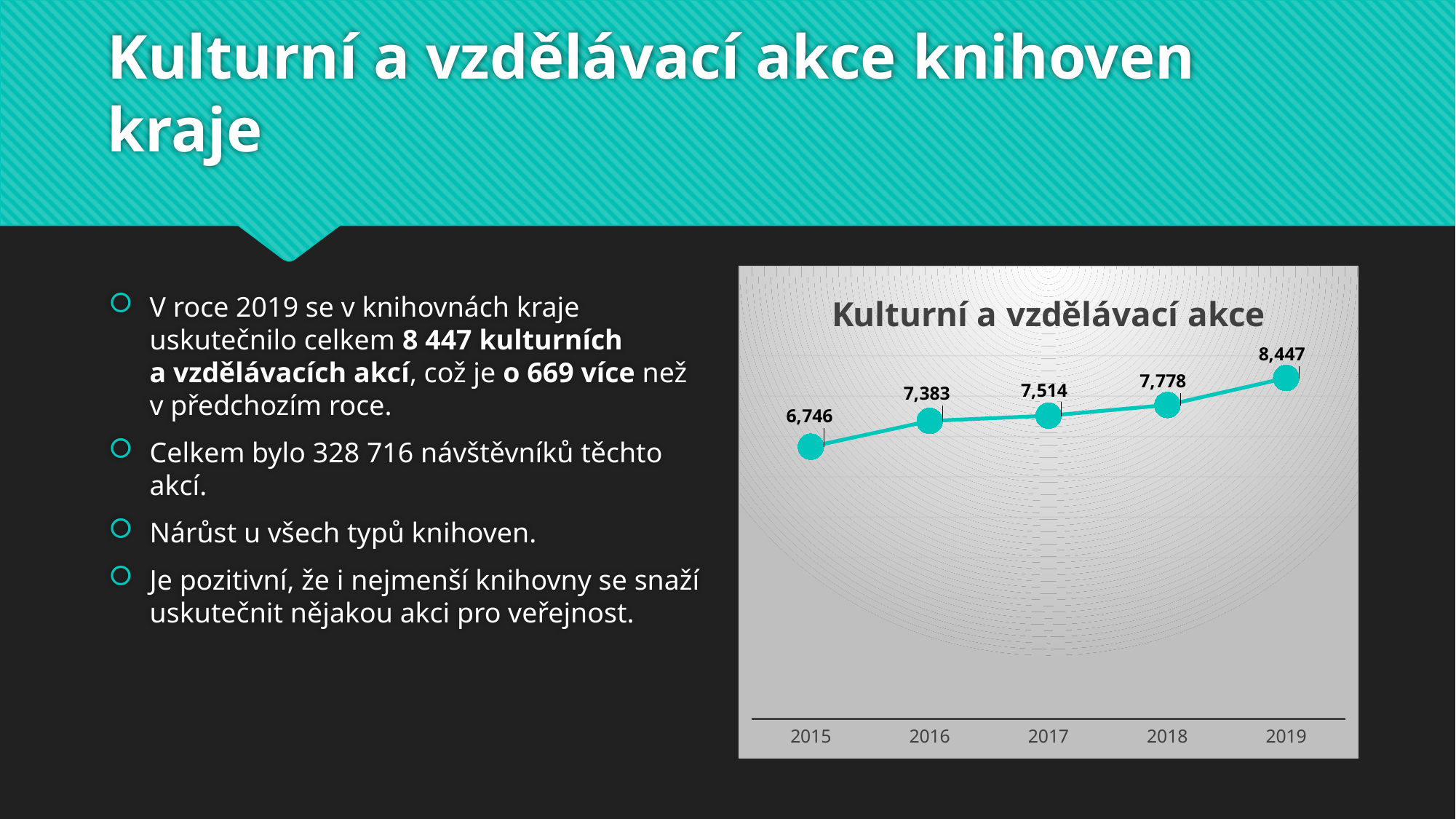
What kind of chart is shown on the slide? line chart What is the value for 2017? 7,514 Which year has the highest value? 2019 What is the value for 2015? 6,746 What is the title of the chart? Kulturní a vzdělávací akce What is the value for 2019? 8,447 Do the values rise or fall from 2015 to 2019? rise What is the difference between the values for 2016 and 2015? 637 What is the difference between the values for 2019 and 2018? 669 Which is larger, the value for 2016 or the value for 2018? 2018 How many data points are plotted on the chart? 5 Which year has the lowest value? 2015